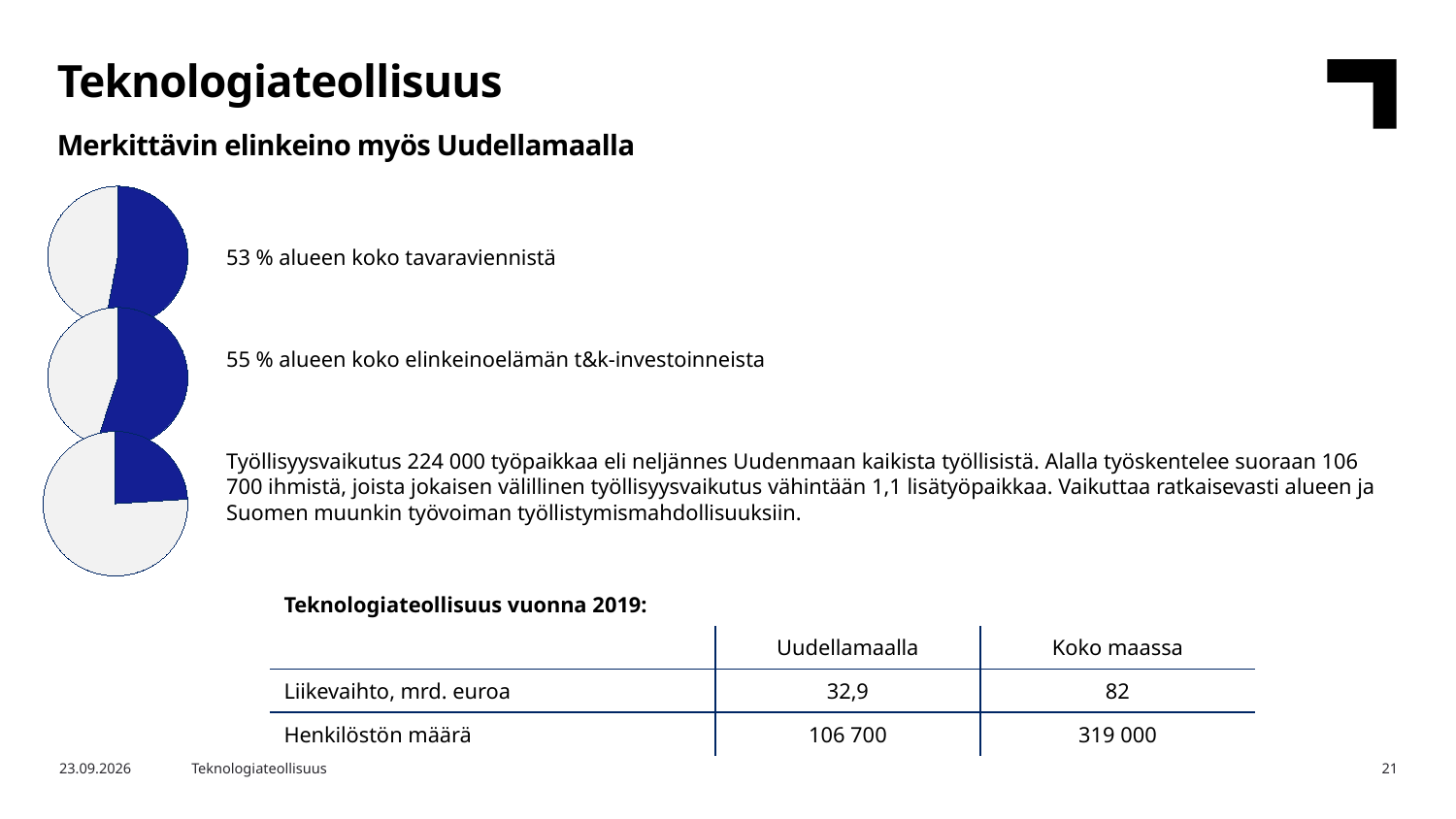
According to the text next to the top pie chart, what share of the region's total goods exports does the dark slice represent? 53 % In the top pie chart, is the dark slice greater or less than 50% of the pie? greater What kind of charts are shown on the left side of the slide? Pie charts What colour is the highlighted slice in each pie chart? Dark blue According to the text next to the middle pie chart, what share of the region's business R&D investments does the dark slice represent? 55 % Which of the three pie charts has the smallest dark slice? The bottom pie chart In the bottom pie chart, is the dark slice greater or less than 50% of the pie? less What is the title of the table below the pie charts? Teknologiateollisuus vuonna 2019: How many pie charts are on the slide? 3 How many slices does the top pie chart have? 2 Is the dark slice in the middle pie chart larger or smaller than the dark slice in the bottom pie chart? Larger